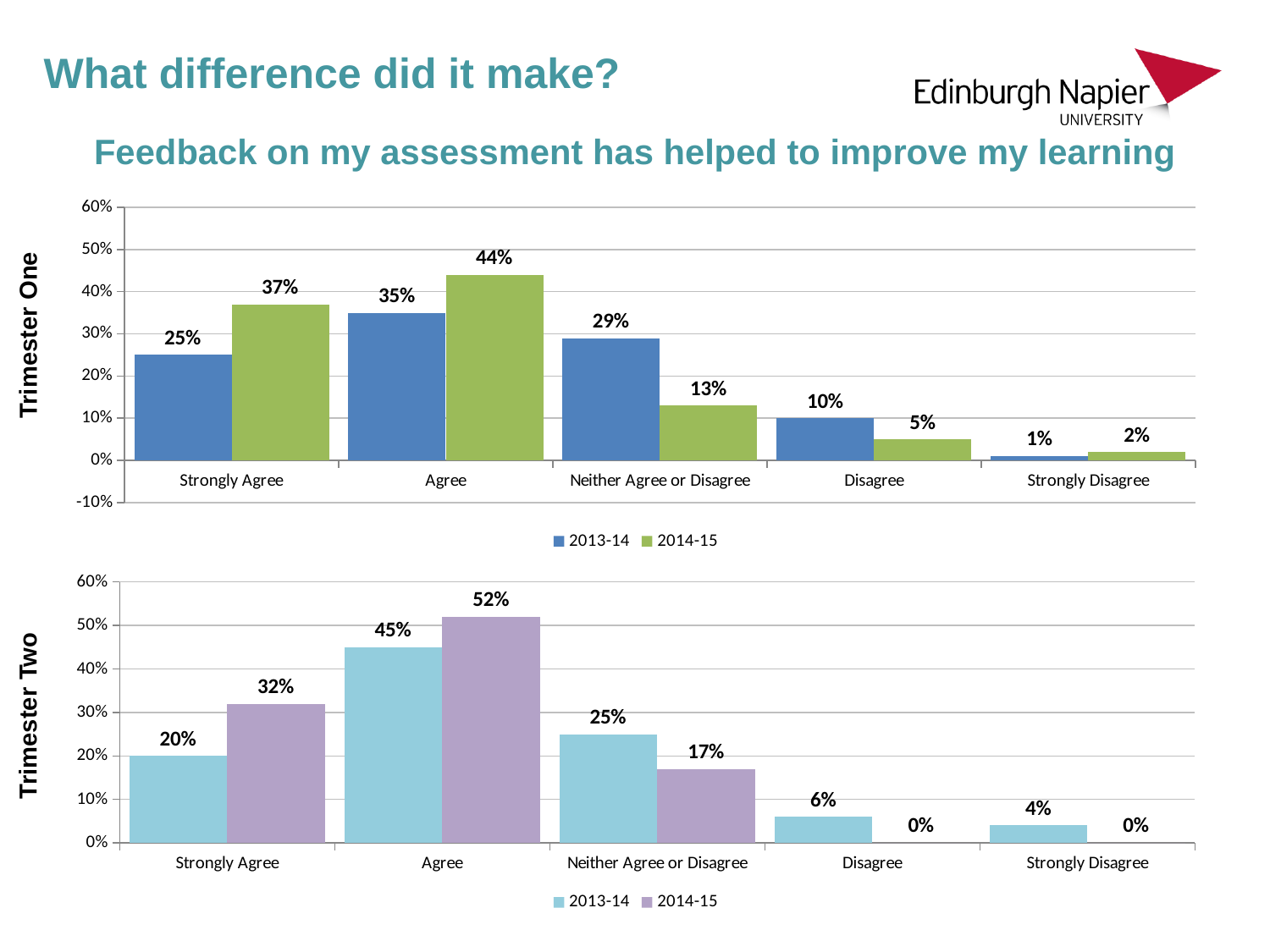
In the Trimester Two chart, what is the difference between the 2013-14 and 2014-15 values for Neither Agree or Disagree? 8% In the Trimester One chart, which category has the lowest value for 2013-14? Strongly Disagree In the Trimester One chart, which is larger for Disagree: the 2013-14 value or the 2014-15 value? 2013-14 How many series does the legend of the Trimester One chart list? 2 In the Trimester Two chart, what is the value for Strongly Agree in 2014-15? 32% How many categories are shown on the x axis of the Trimester Two chart? 5 What kind of chart is the Trimester Two chart? Bar chart In the Trimester Two chart, which category has the highest value for 2014-15? Agree In the Trimester One chart, what is the value for Agree in 2014-15? 44% In the Trimester One chart, what is the value for Neither Agree or Disagree in 2013-14? 29% In the Trimester One chart, what is the difference between the 2014-15 and 2013-14 values for Strongly Agree? 12% In the Trimester Two chart, what is the value for Disagree in 2014-15? 0%